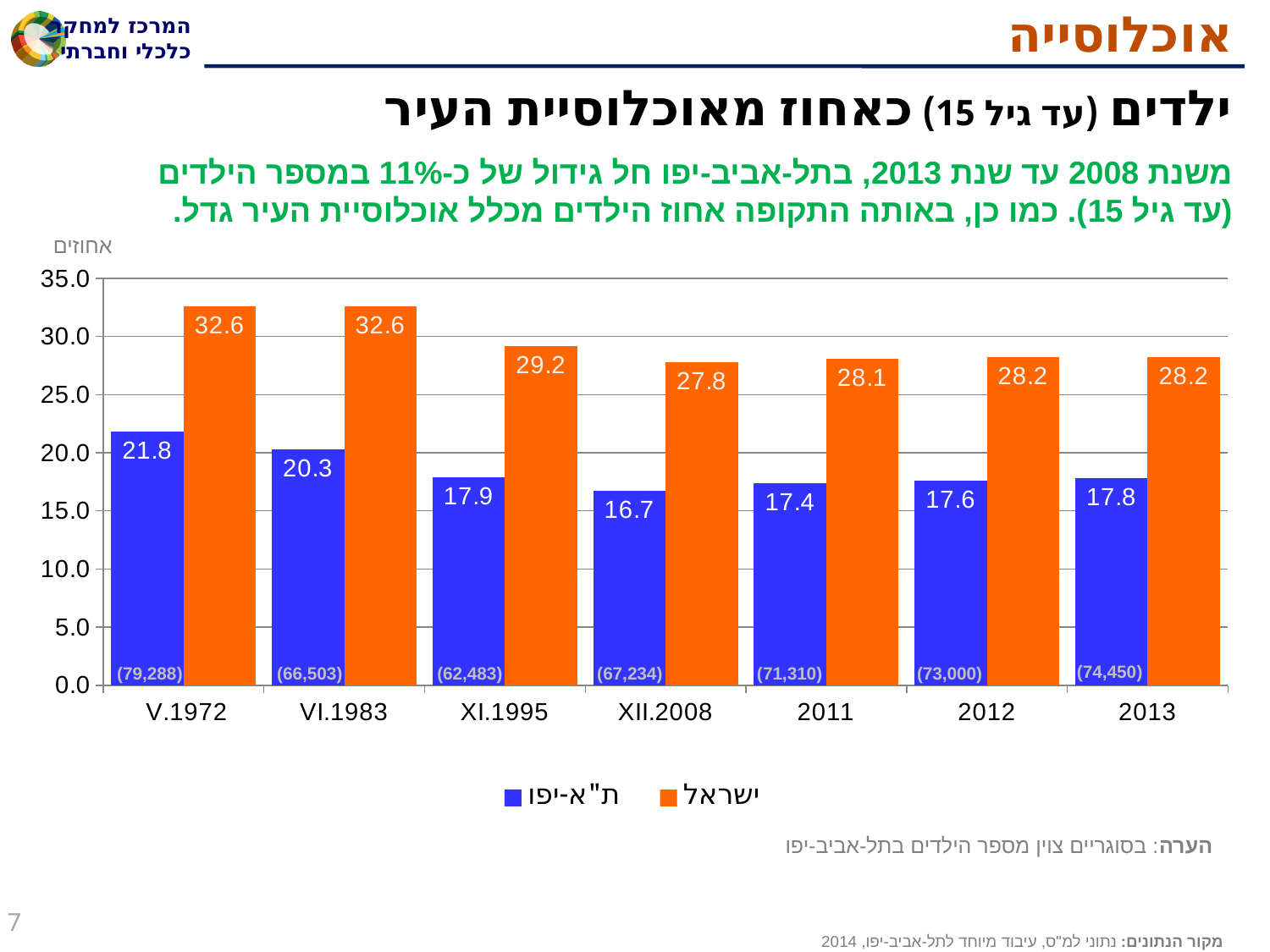
Which is larger in VI.1983, the value for ישראל or for ת"א-יפו? ישראל Does the value for ת"א-יפו rise or fall from V.1972 to XII.2008? fall What is the value for ת"א-יפו in 2013? 17.8 Is the value for ישראל in XI.1995 greater or less than 25.0? greater What number is printed in parentheses at the base of the ת"א-יפו bar for 2013? (74,450) What is the value for ישראל in XII.2008? 27.8 What is the difference between the ישראל and ת"א-יפו values in 2011? 10.7 How many categories (years) are shown on the x axis? 7 What type of chart is shown on the slide? bar chart In which year is the value for ת"א-יפו lowest? XII.2008 What is the value for ת"א-יפו in V.1972? 21.8 How many series does the legend list? 2